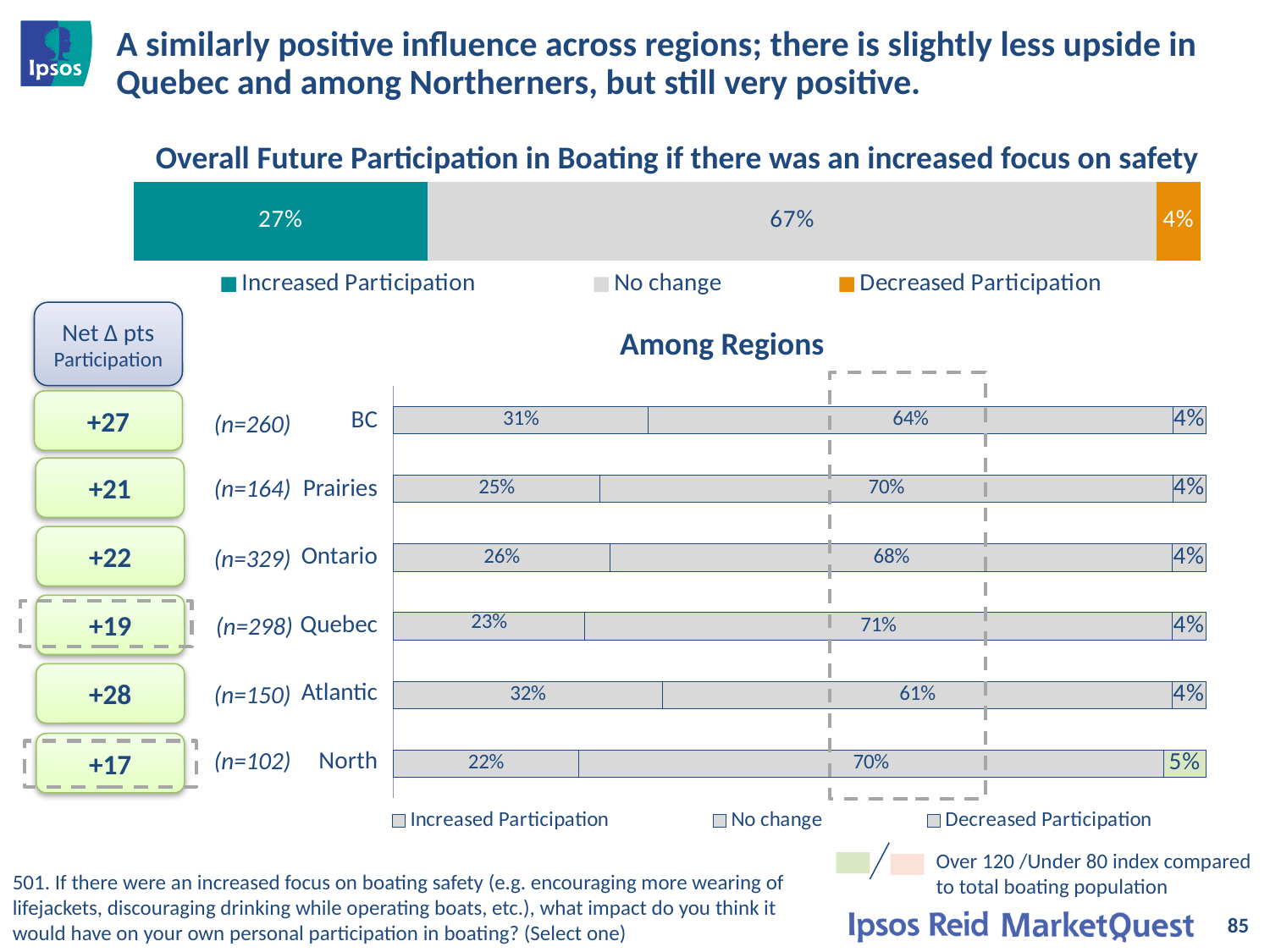
In the top 'Overall Future Participation in Boating' chart, what percentage is shown for No change? 67% In the 'Among Regions' chart, what is the Increased Participation value for Atlantic? 32% In the top 'Overall Future Participation in Boating' chart, what percentage is shown for Decreased Participation? 4% In the 'Among Regions' chart, which region has the highest Increased Participation value? Atlantic In the 'Among Regions' chart, which region has the lowest Increased Participation value? North In the 'Among Regions' chart, what is the difference between the Increased Participation values for BC and Prairies? 6 percentage points In the top 'Overall Future Participation in Boating' chart, what percentage is shown for Increased Participation? 27% In the 'Among Regions' chart, which region has the larger No change value, Ontario or Atlantic? Ontario How many regions are shown in the 'Among Regions' chart? 6 What type of chart is the 'Among Regions' chart? Stacked bar chart How many series does the legend of the 'Among Regions' chart list? 3 In the 'Among Regions' chart, what is the No change value for Quebec? 71%